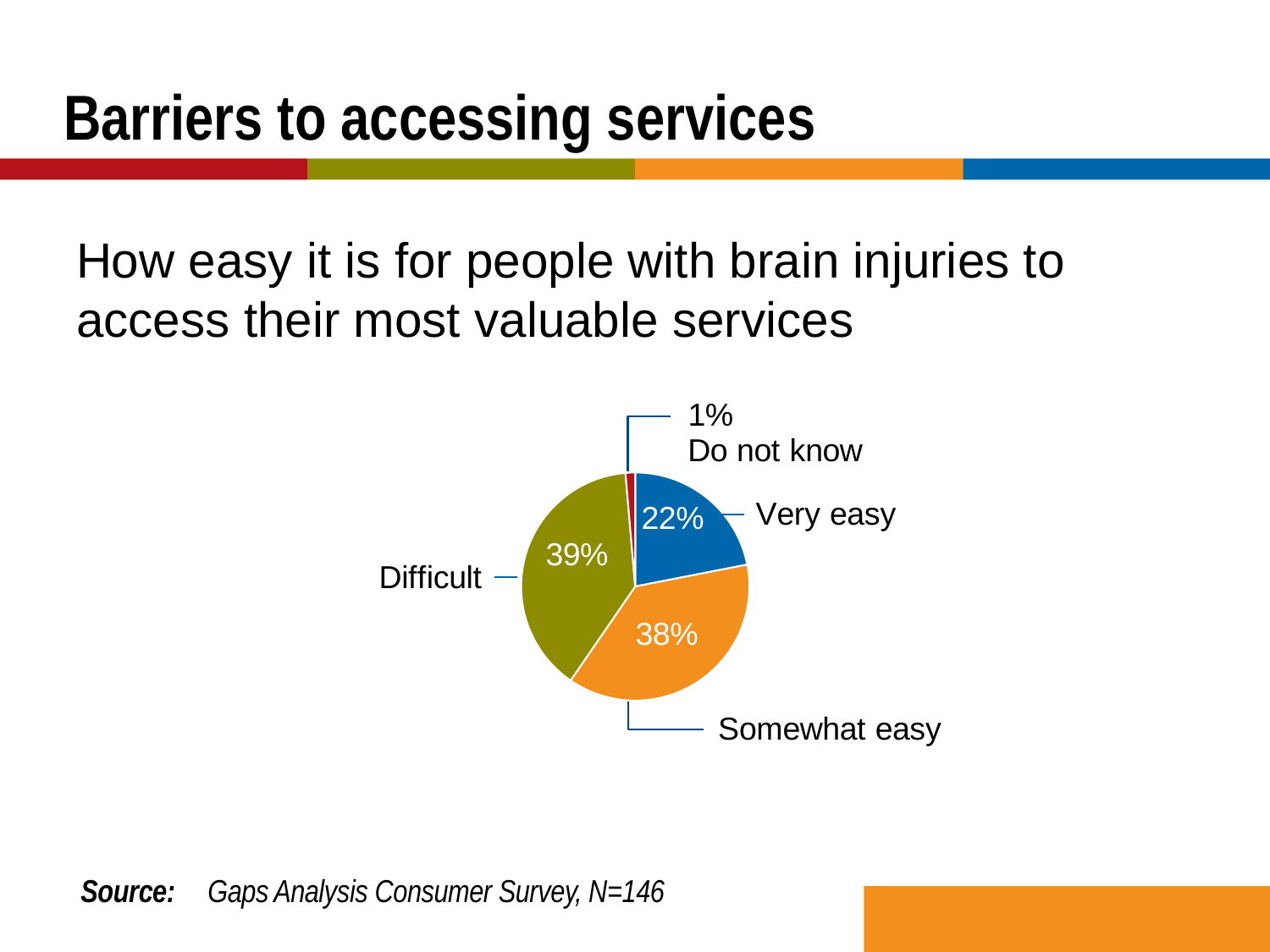
What percentage of respondents answered Do not know? 1% What kind of chart is shown on the slide? Pie chart What is the difference in percentage points between the Difficult and Very easy slices? 17 What share of the pie is labelled Somewhat easy? 38% What percentage of respondents said it is very easy to access their most valuable services? 22% Which response has the largest share of the pie? Difficult What percentage of respondents said accessing services is difficult? 39% How many slices does the pie chart have? 4 Which slice is larger, Very easy or Somewhat easy? Somewhat easy Which response has the smallest share of the pie? Do not know What colour is the Difficult slice of the pie? Green What is the combined share of the Very easy and Somewhat easy slices? 60%